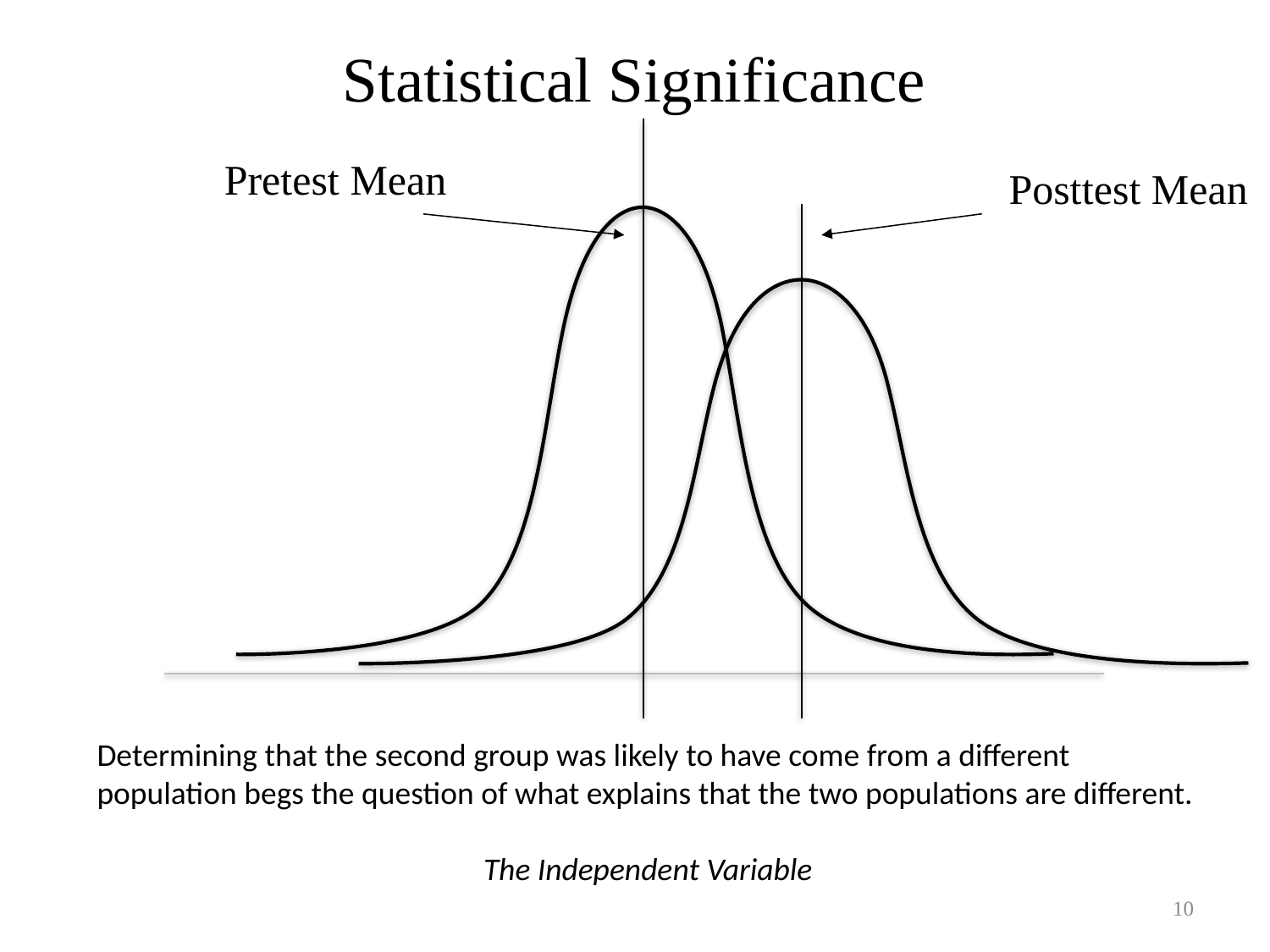
Which mean line is marked further to the left on the chart? Pretest Mean What is the title of the chart on the slide? Statistical Significance What are the two labels pointing to the vertical lines on the chart? Pretest Mean and Posttest Mean How many vertical mean lines are drawn on the chart? 2 Which curve reaches the higher peak, the one at the Pretest Mean or the one at the Posttest Mean? the Pretest Mean curve How many curves are plotted on the chart? 2 Which mean is marked further to the right on the chart, the Pretest Mean or the Posttest Mean? Posttest Mean What kind of chart is shown on the slide? line chart (two bell-shaped curves)